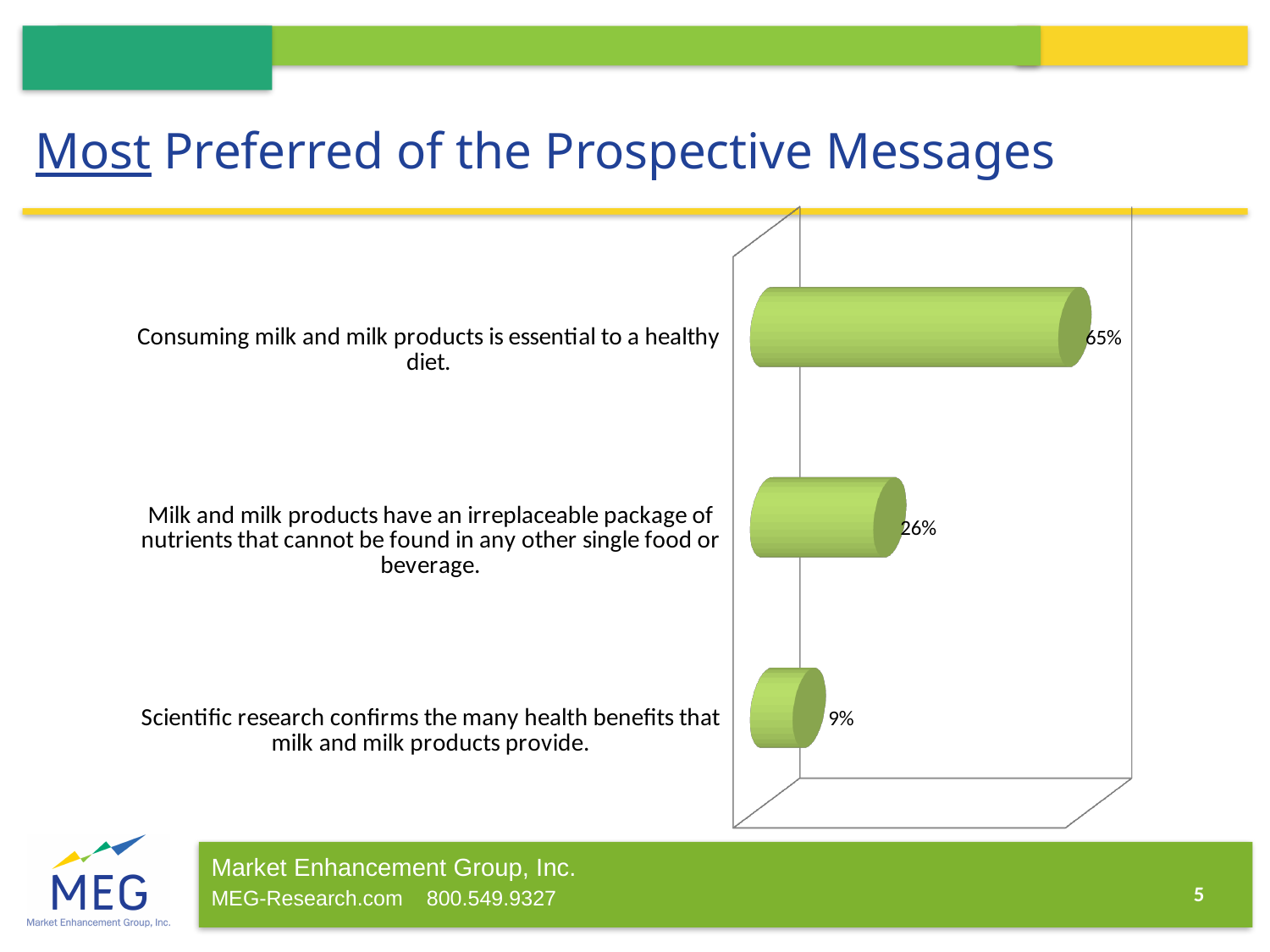
Which has a larger value: the "irreplaceable package of nutrients" message or the "scientific research" message? Milk and milk products have an irreplaceable package of nutrients that cannot be found in any other single food or beverage. Which message has the lowest percentage? Scientific research confirms the many health benefits that milk and milk products provide. What is the difference in percentage points between the "irreplaceable package of nutrients" message and the "scientific research" message? 17 What is the difference in percentage points between the "essential to a healthy diet" message and the "irreplaceable package of nutrients" message? 39 Which message has the highest percentage? Consuming milk and milk products is essential to a healthy diet. What is the total of the three percentages shown in the chart? 100% What value is shown for the message "Milk and milk products have an irreplaceable package of nutrients that cannot be found in any other single food or beverage."? 26% What is the title of the slide? Most Preferred of the Prospective Messages What percentage of respondents most preferred the message "Consuming milk and milk products is essential to a healthy diet."? 65% How many messages are shown in the chart? 3 What value is shown for the message "Scientific research confirms the many health benefits that milk and milk products provide."? 9% What kind of chart is shown on the slide? Bar chart